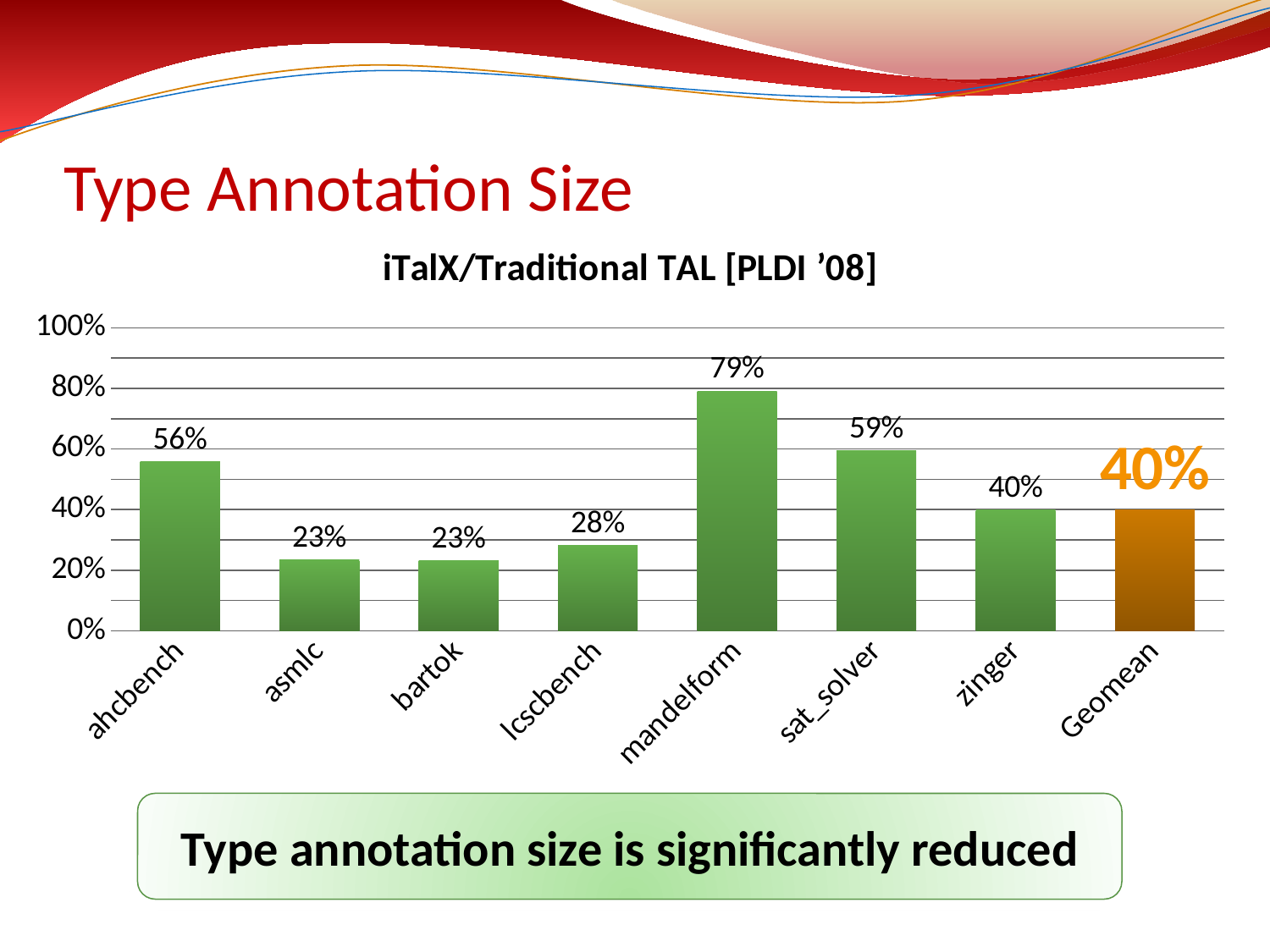
Is the value for sat_solver greater or less than 40%? greater What is the difference between the values for mandelform and lcscbench? 51% What is the value for Geomean? 40% What is the value for sat_solver? 59% Which category has the highest value? mandelform Which bar is coloured differently from the others? Geomean What is the title of the chart? iTalX/Traditional TAL [PLDI '08] What kind of chart is shown? bar chart What is the value for ahcbench? 56% Which is larger, the value for ahcbench or the value for zinger? ahcbench What is the value for mandelform? 79% How many categories are shown on the x axis? 8